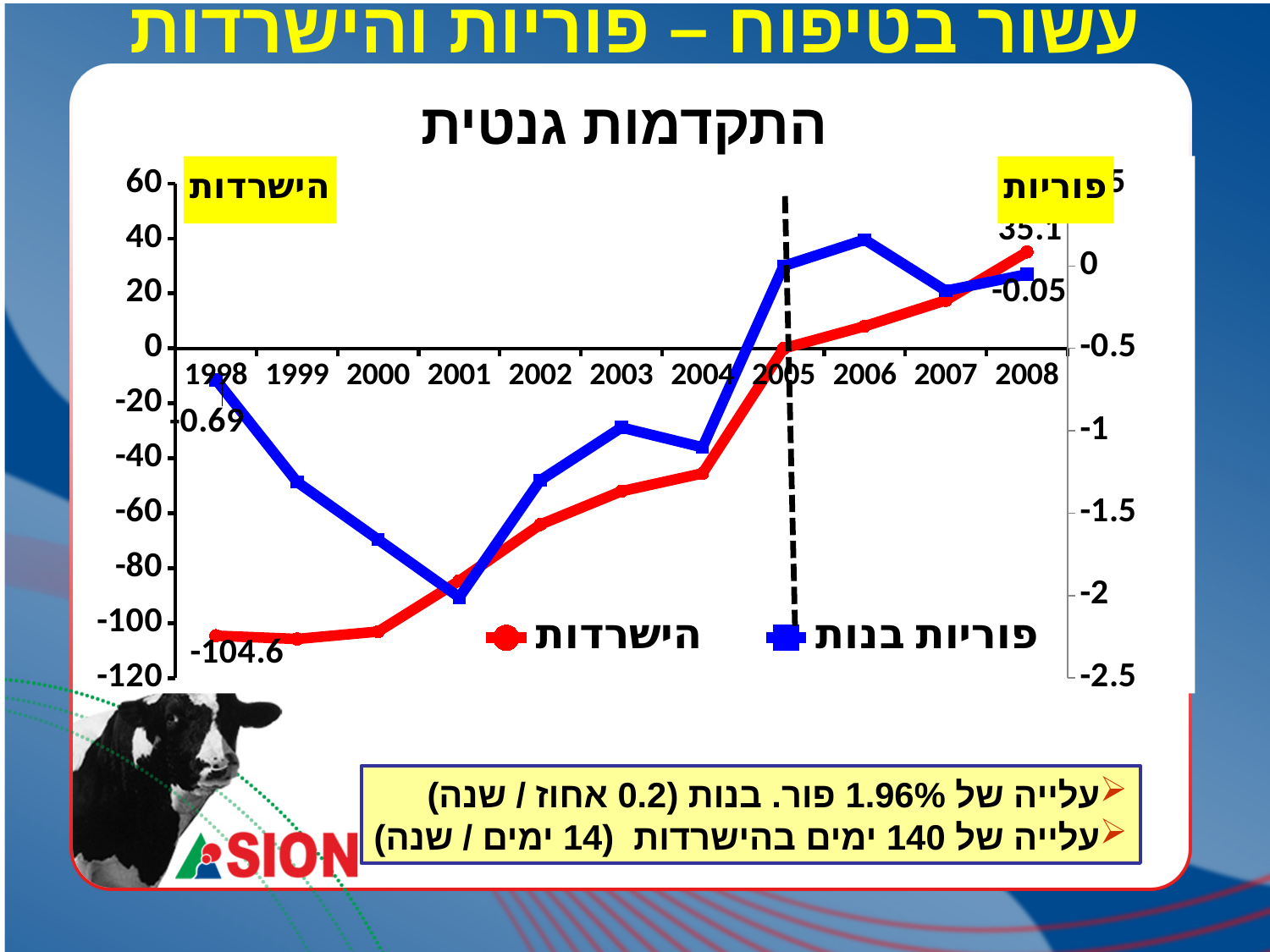
What is the value of הישרדות (survival) in 2008? 35.1 Which year has the lowest פוריות בנות (daughter fertility) value? 2001 By how much did the הישרדות (survival) value change from 1998 to 2008? 139.7 How many years are plotted along the x axis? 11 What is the value of פוריות בנות (daughter fertility) in 1998? -0.69 What kind of chart is shown on the slide? line chart Is the הישרדות (survival) value for 2003 greater or less than -40? less What is the value of פוריות בנות (daughter fertility) in 2008? -0.05 How many series does the chart legend list? 2 Which year has the highest פוריות בנות (daughter fertility) value? 2006 What is the value of הישרדות (survival) in 1998? -104.6 What is the title of the chart? התקדמות גנטית